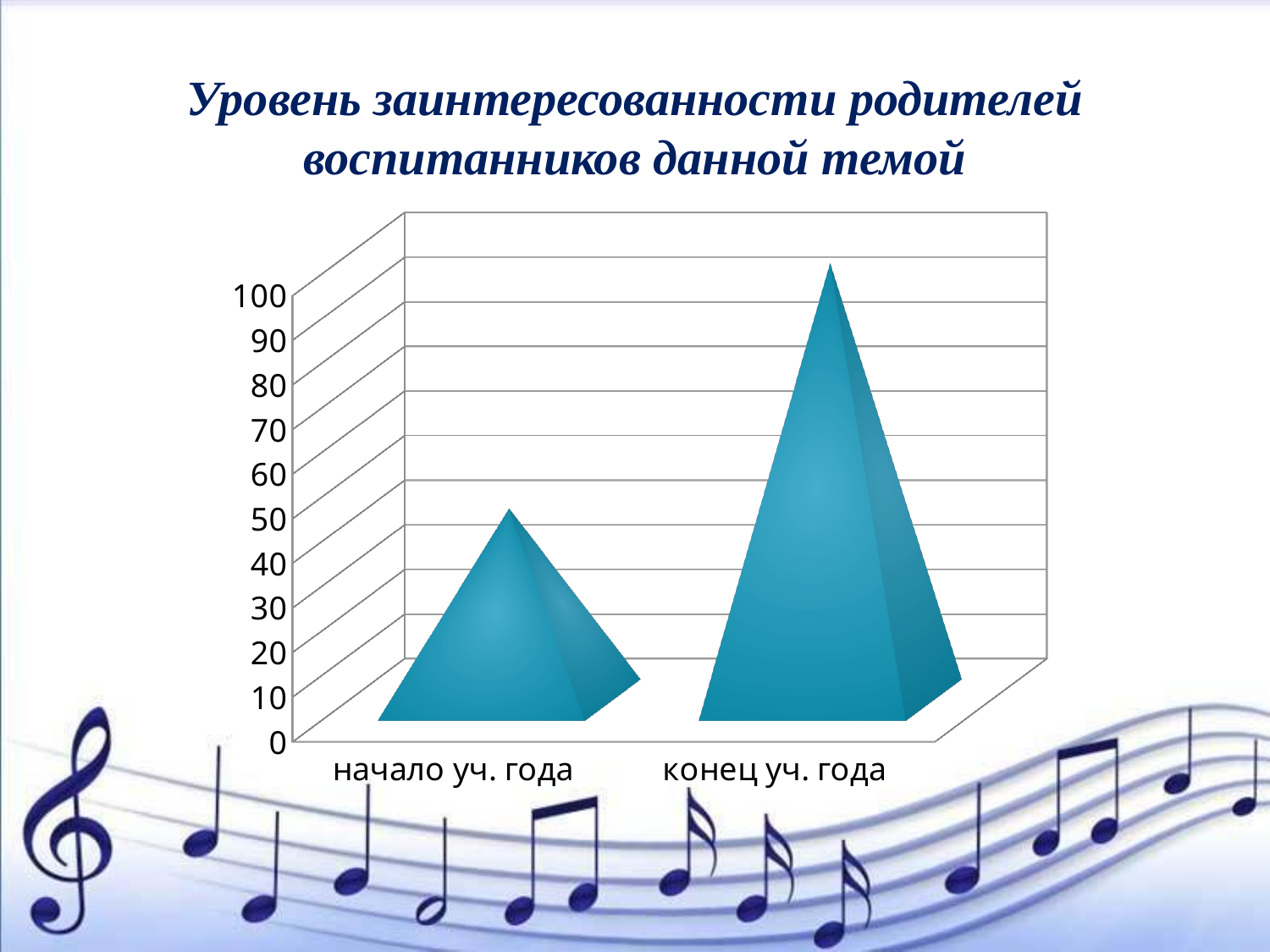
Is the value for конец уч. года greater or less than 50? greater What kind of chart is shown on the slide? bar chart Do the values rise or fall from начало уч. года to конец уч. года? rise What is the highest value labelled on the vertical axis of the chart? 100 What is the title of the chart on the slide? Уровень заинтересованности родителей воспитанников данной темой Which category has the highest value in the chart? конец уч. года Is the value for начало уч. года greater or less than 80? less Which is larger: the value for начало уч. года or the value for конец уч. года? конец уч. года How many categories are shown on the x axis of the chart? 2 Which category has the lowest value in the chart? начало уч. года